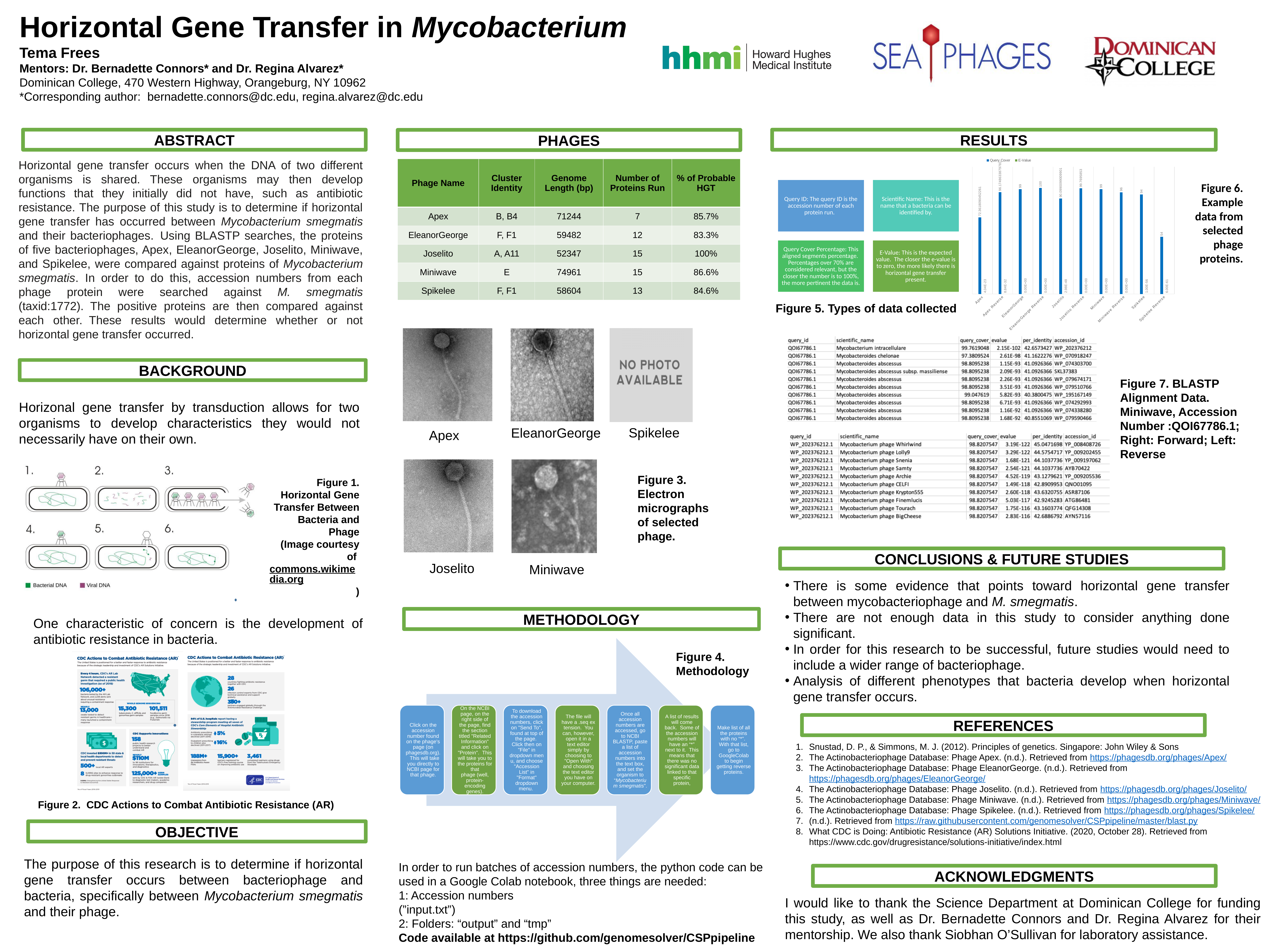
In the Figure 6 bar chart, which Query_Cover bar is taller: Spikelee or Spikelee Reverse? Spikelee How many categories (phage protein entries) are shown along the x axis of the Figure 6 bar chart? 10 How many series does the legend of the Figure 6 bar chart list? 2 What kind of chart is Figure 6 (Example data from selected phage proteins)? bar chart What colour are the Query_Cover bars in the Figure 6 bar chart? blue In the Figure 6 bar chart, which Query_Cover bar is taller: Joselito or Spikelee Reverse? Joselito What are the two series named in the legend of the Figure 6 bar chart? Query_Cover and E-Value In the Figure 6 bar chart, which category has the lowest Query_Cover bar? Spikelee Reverse In the Figure 6 bar chart, which Query_Cover bar is taller: Apex or Apex Reverse? Apex Reverse